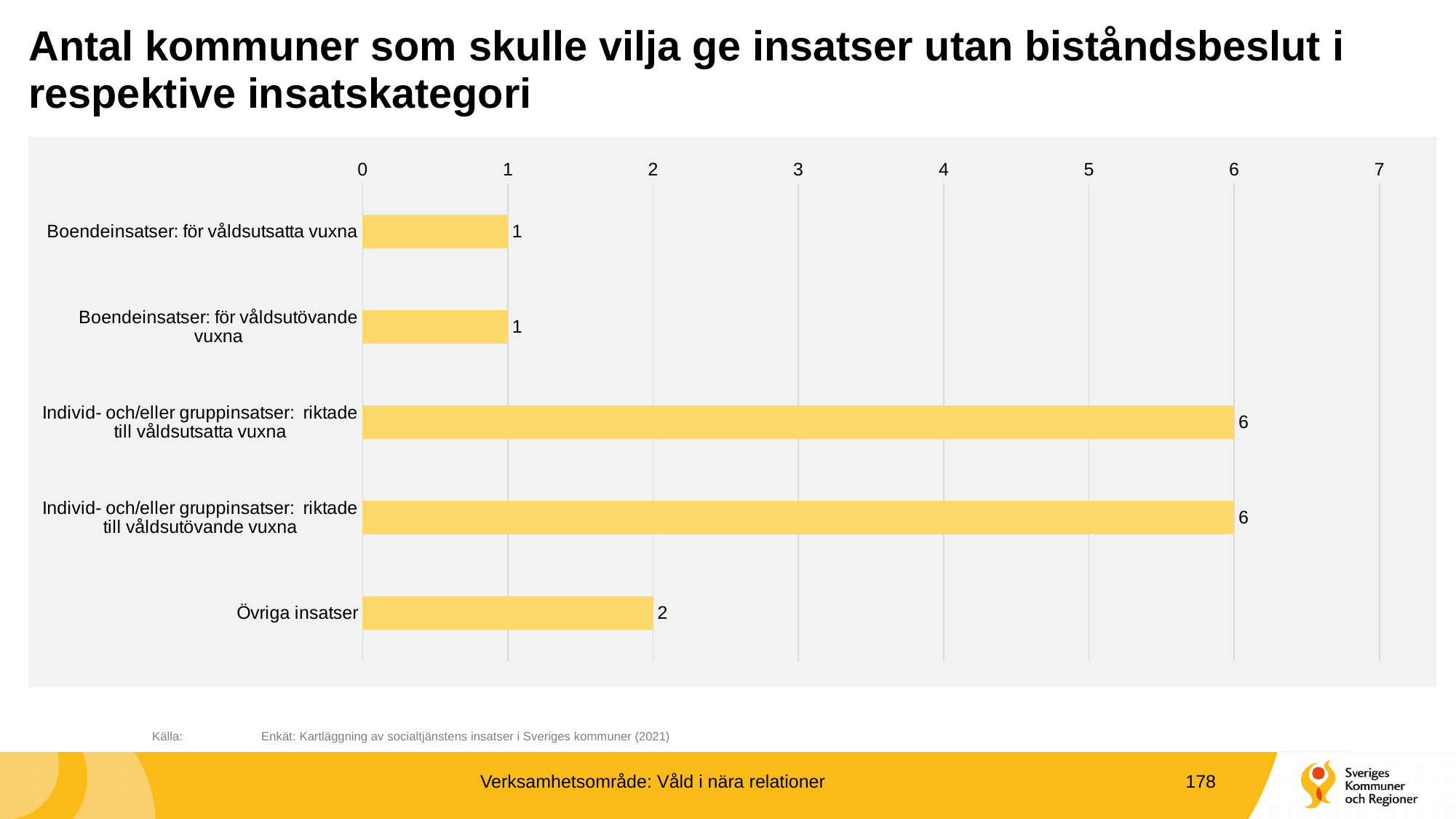
What is the difference between the value for Övriga insatser and the value for Boendeinsatser: för våldsutövande vuxna? 1 Which category has the lowest value, Övriga insatser or Boendeinsatser: för våldsutsatta vuxna? Boendeinsatser: för våldsutsatta vuxna What kind of chart is shown on the slide? bar chart What is the value for Övriga insatser? 2 Is the value for Individ- och/eller gruppinsatser: riktade till våldsutsatta vuxna greater or less than 4? greater What is the value for Boendeinsatser: för våldsutsatta vuxna? 1 What is the highest value shown on the x axis? 7 What is the difference between the value for Individ- och/eller gruppinsatser: riktade till våldsutsatta vuxna and the value for Övriga insatser? 4 What is the value for Boendeinsatser: för våldsutövande vuxna? 1 What is the value for Individ- och/eller gruppinsatser: riktade till våldsutövande vuxna? 6 How many categories are shown in the chart? 5 What source is cited below the chart? Enkät: Kartläggning av socialtjänstens insatser i Sveriges kommuner (2021)